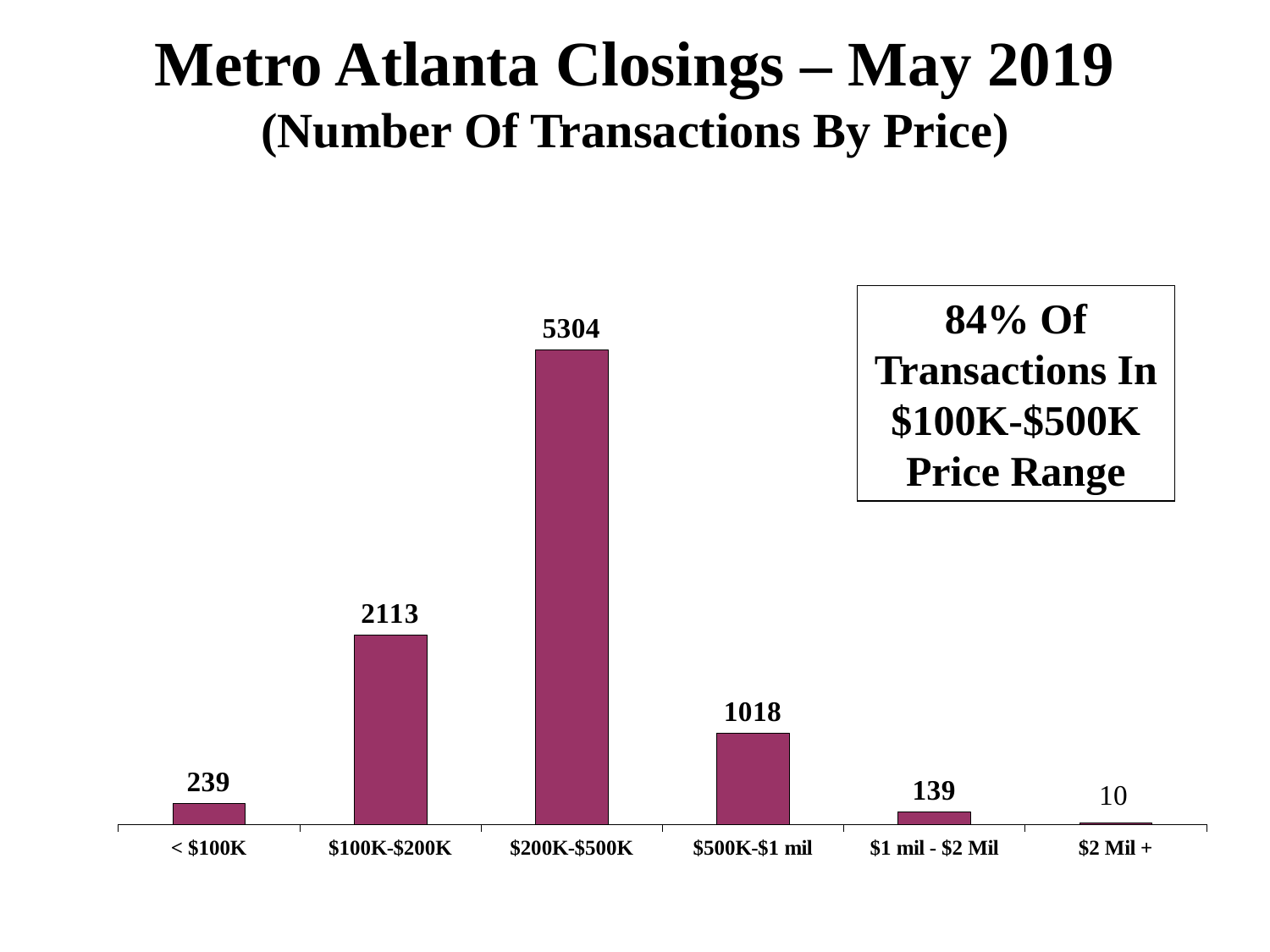
Which price range has the lowest number of transactions? $2 Mil + What is the number of transactions for the $100K-$200K category? 2113 How many transactions are shown for the $2 Mil + category? 10 How many more transactions were there in the $500K-$1 mil range than in the < $100K range? 779 What type of chart is shown on the slide? Bar chart Which price range has the highest number of transactions? $200K-$500K Which has more transactions: < $100K or $1 mil - $2 Mil? < $100K What is the difference in transactions between the $200K-$500K and $100K-$200K price ranges? 3191 How many price range categories are shown on the chart? 6 According to the text box on the slide, what percentage of transactions were in the $100K-$500K price range? 84% What value is shown for the $1 mil - $2 Mil price range? 139 How many transactions were closed in the $200K-$500K price range? 5304